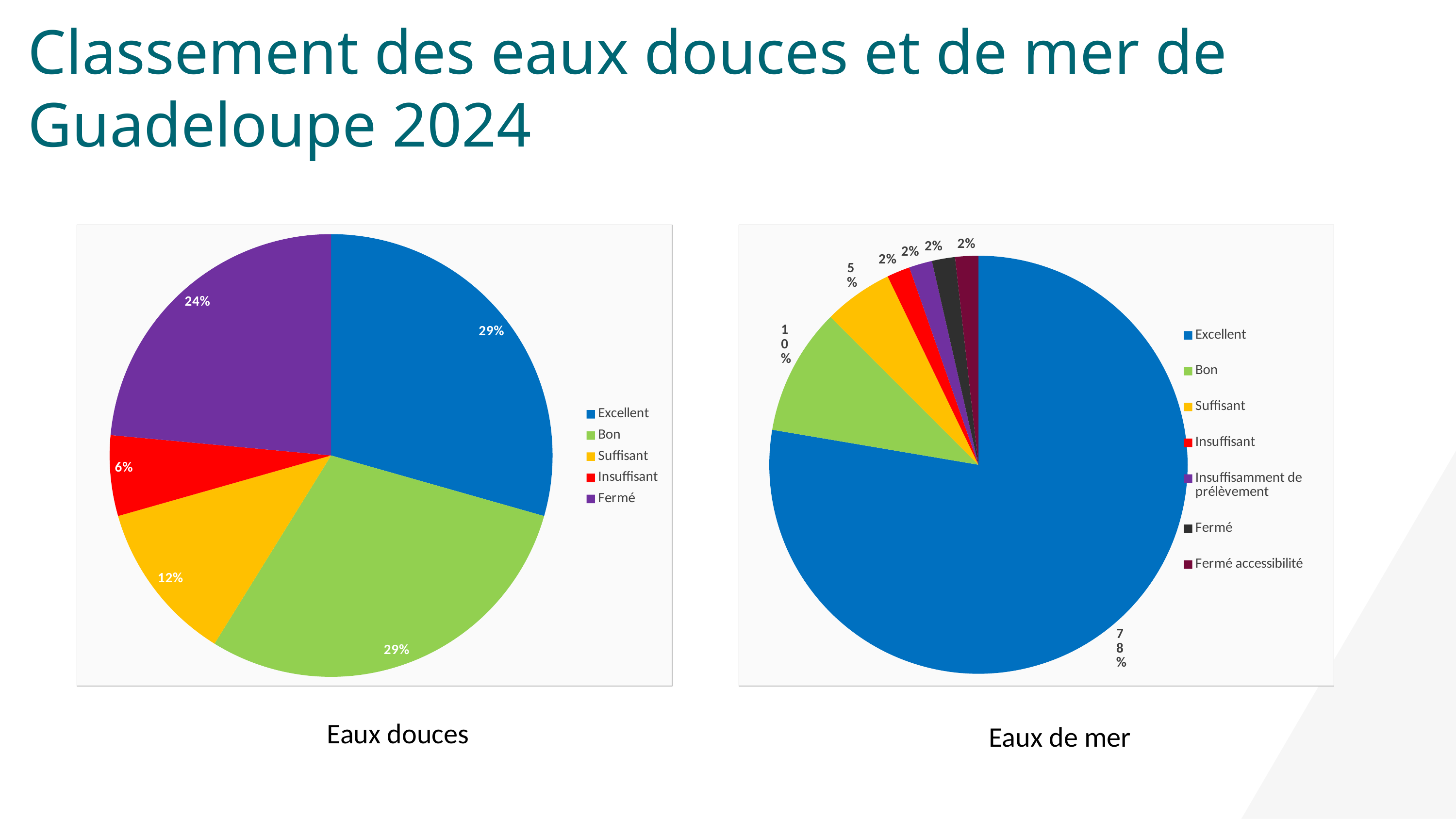
What kind of chart is the Eaux de mer chart? Pie chart In the Eaux de mer chart, which category has the largest share? Excellent In the Eaux douces chart, what share does Fermé have? 24% In the Eaux douces chart, what share does Suffisant have? 12% In the Eaux douces chart, how many categories does the legend list? 5 In the Eaux de mer chart, what share does Bon have? 10% In the Eaux de mer chart, what colour is the Fermé accessibilité slice? Dark maroon (burgundy) In the Eaux de mer chart, which is larger, the Bon share or the Suffisant share? Bon In the Eaux douces chart, which category has the smallest share? Insuffisant In the Eaux de mer chart, how many categories does the legend list? 7 In the Eaux douces chart, what is the difference between the Fermé share and the Suffisant share? 12%